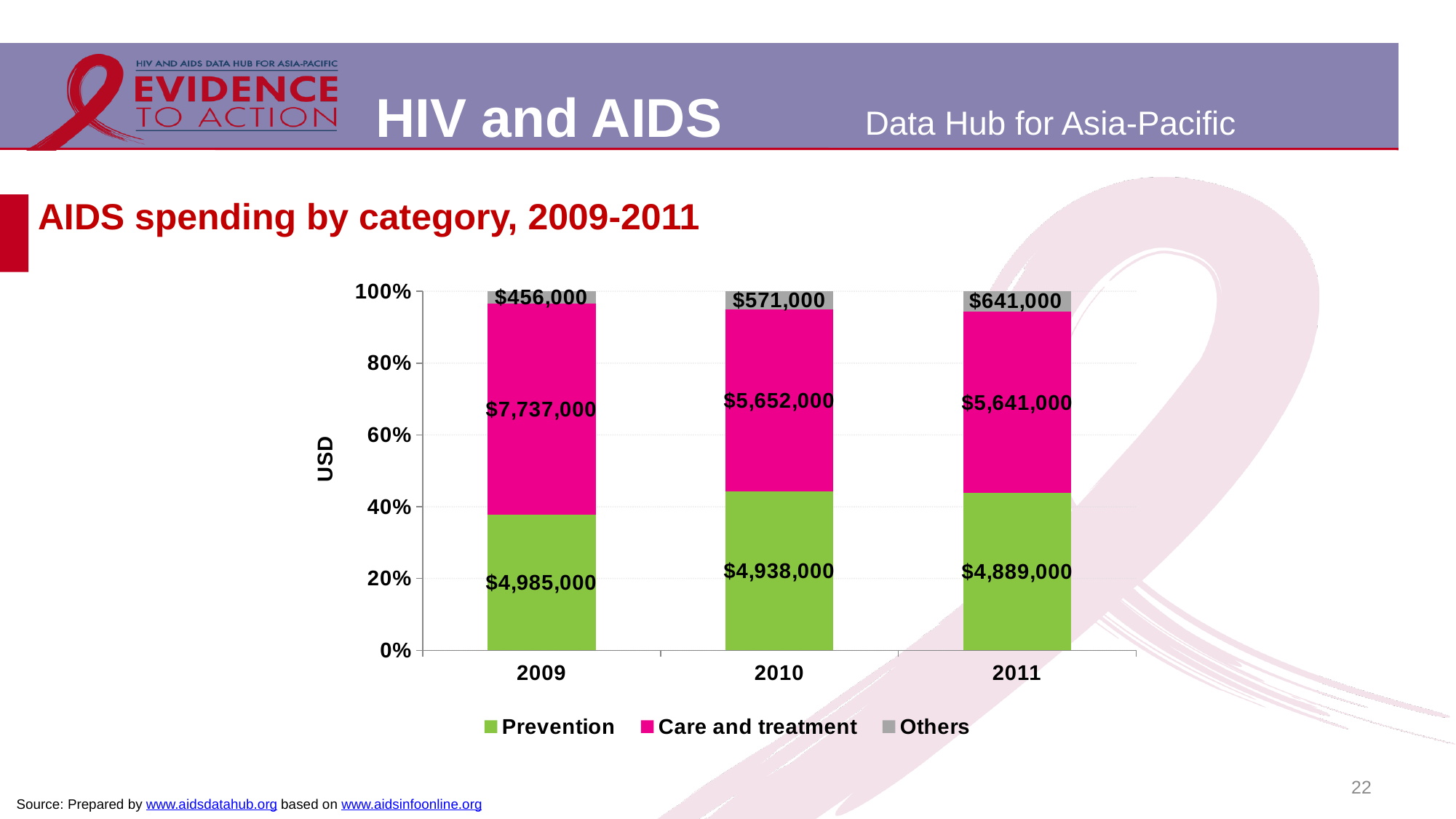
How much more was spent on Care and treatment in 2009 than in 2010? $2,085,000 What was the spending on Others in 2010? $571,000 How many series does the legend list? 3 What is the total AIDS spending across all three categories in 2009? $13,178,000 What was the spending on Care and treatment in 2009? $7,737,000 Does spending on Others rise or fall from 2009 to 2011? Rise What was the spending on Prevention in 2011? $4,889,000 What type of chart is shown on the slide? Stacked bar chart How many years are shown on the x axis? 3 Which was larger in 2011: spending on Prevention or on Care and treatment? Care and treatment In which year was spending on Others the highest? 2011 In which year was spending on Prevention the lowest? 2011